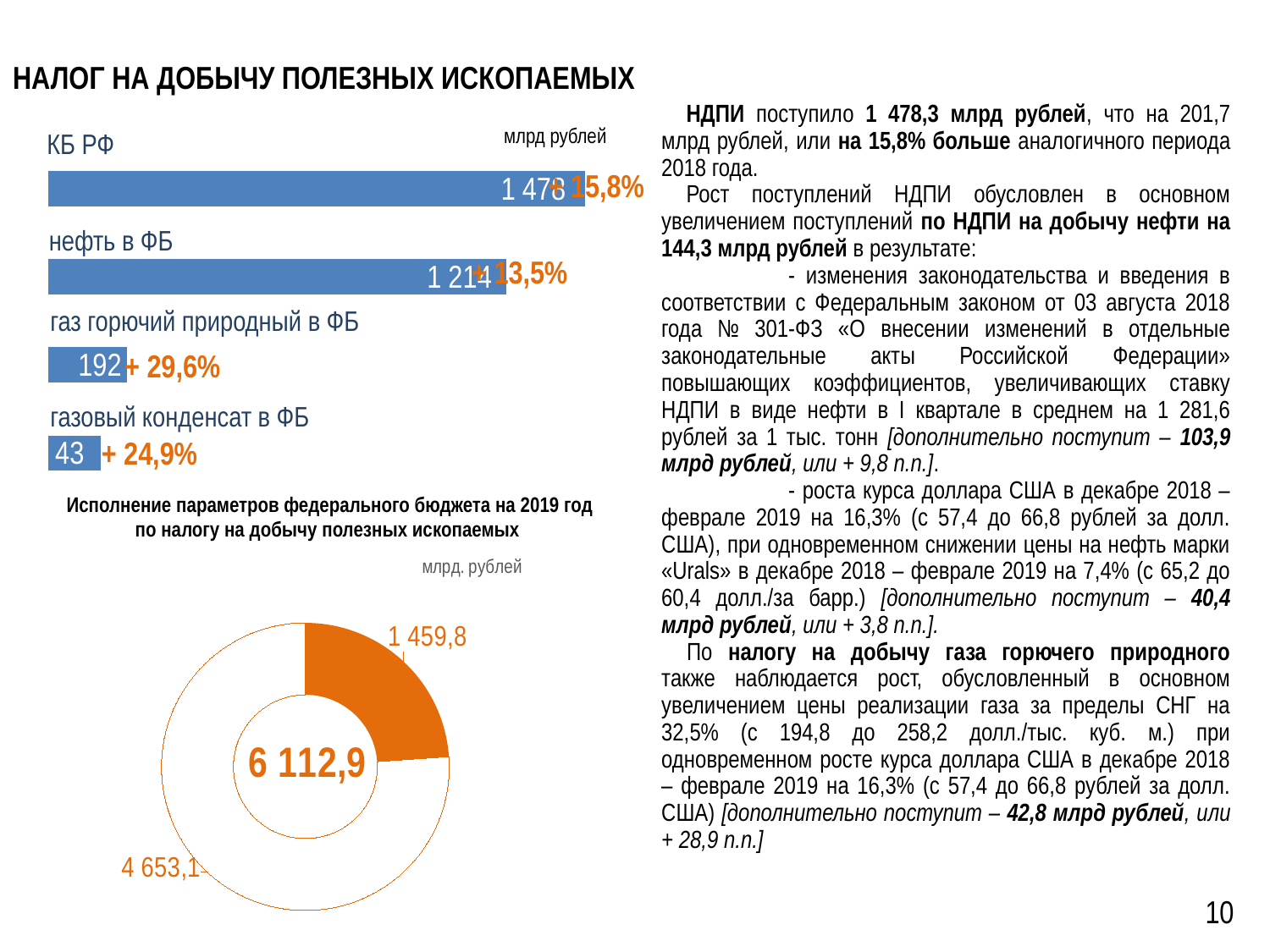
In the doughnut chart at the bottom left, what total is shown in the centre? 6 112,9 In the bar chart at the top left, what percentage change is shown next to газовый конденсат в ФБ? + 24,9% In the bar chart at the top left, which category has the shortest bar? газовый конденсат в ФБ In the bar chart at the top left, which category has the longest bar? КБ РФ In the bar chart at the top left, what is the value for газ горючий природный в ФБ? 192 In the bar chart at the top left, what percentage change is shown next to газ горючий природный в ФБ? + 29,6% In the bar chart at the top left, what is the value for газовый конденсат в ФБ? 43 What kind of chart is the chart at the bottom left titled 'Исполнение параметров федерального бюджета на 2019 год по налогу на добычу полезных ископаемых'? Doughnut (pie) chart In the bar chart at the top left, which is larger: нефть в ФБ or газ горючий природный в ФБ? нефть в ФБ In the doughnut chart at the bottom left, what is the value of the orange segment? 1 459,8 In the bar chart at the top left, what is the difference between the values for газ горючий природный в ФБ and газовый конденсат в ФБ? 149 How many categories are shown in the bar chart at the top left? 4